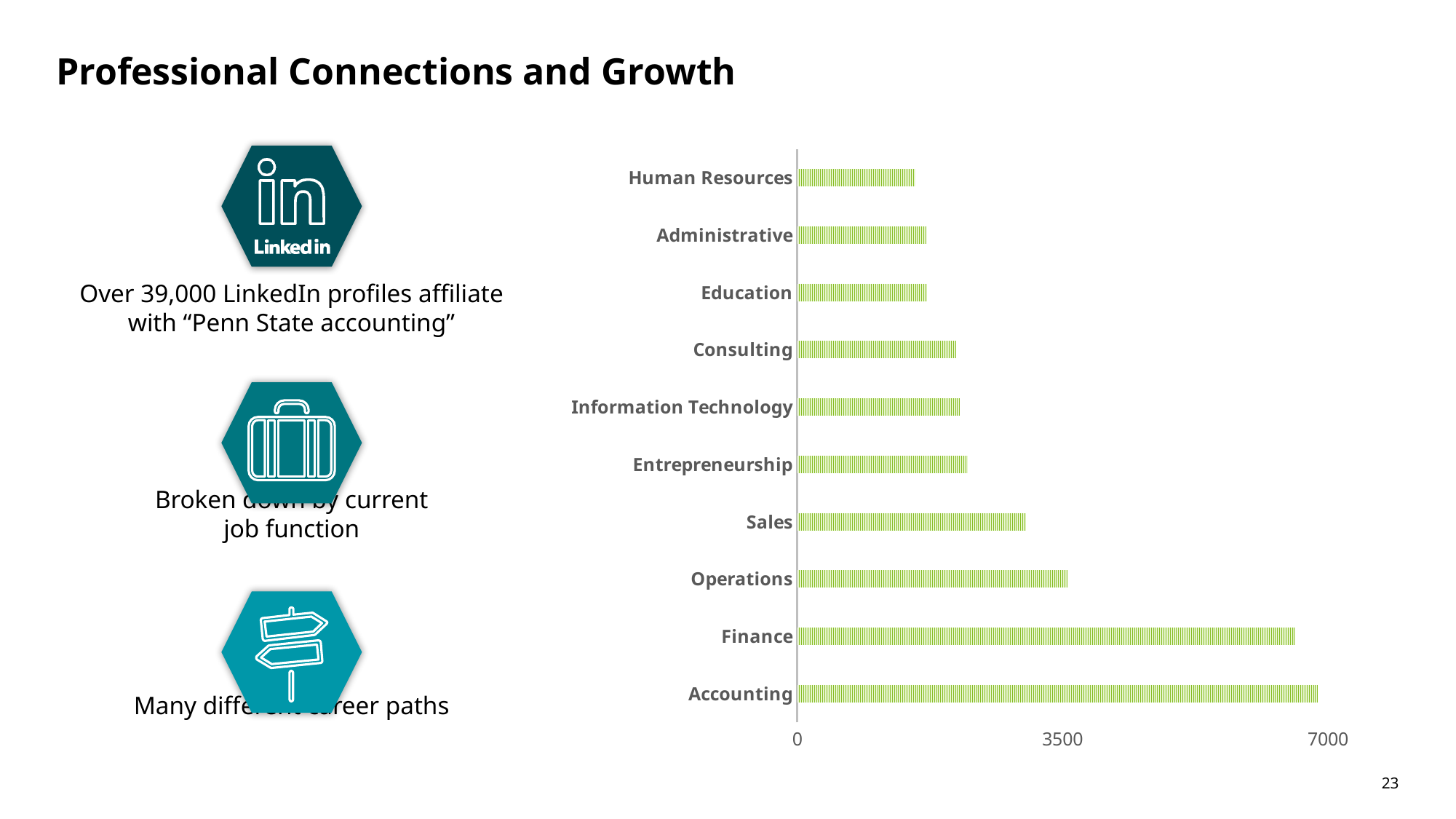
Is the value for Human Resources greater or less than 3500? less What kind of chart is shown on the slide? bar chart What is the highest value labelled on the chart's horizontal axis? 7000 Do the bar values increase or decrease going from the top category (Human Resources) to the bottom category (Accounting)? increase Is the value for Accounting greater or less than 3500? greater Which has a larger value, Finance or Operations? Finance How many job function categories are shown in the chart? 10 Which has a larger value, Sales or Entrepreneurship? Sales Which job function has the longest bar in the chart? Accounting Is the value for Sales greater or less than 3500? less Which job function has the shortest bar in the chart? Human Resources